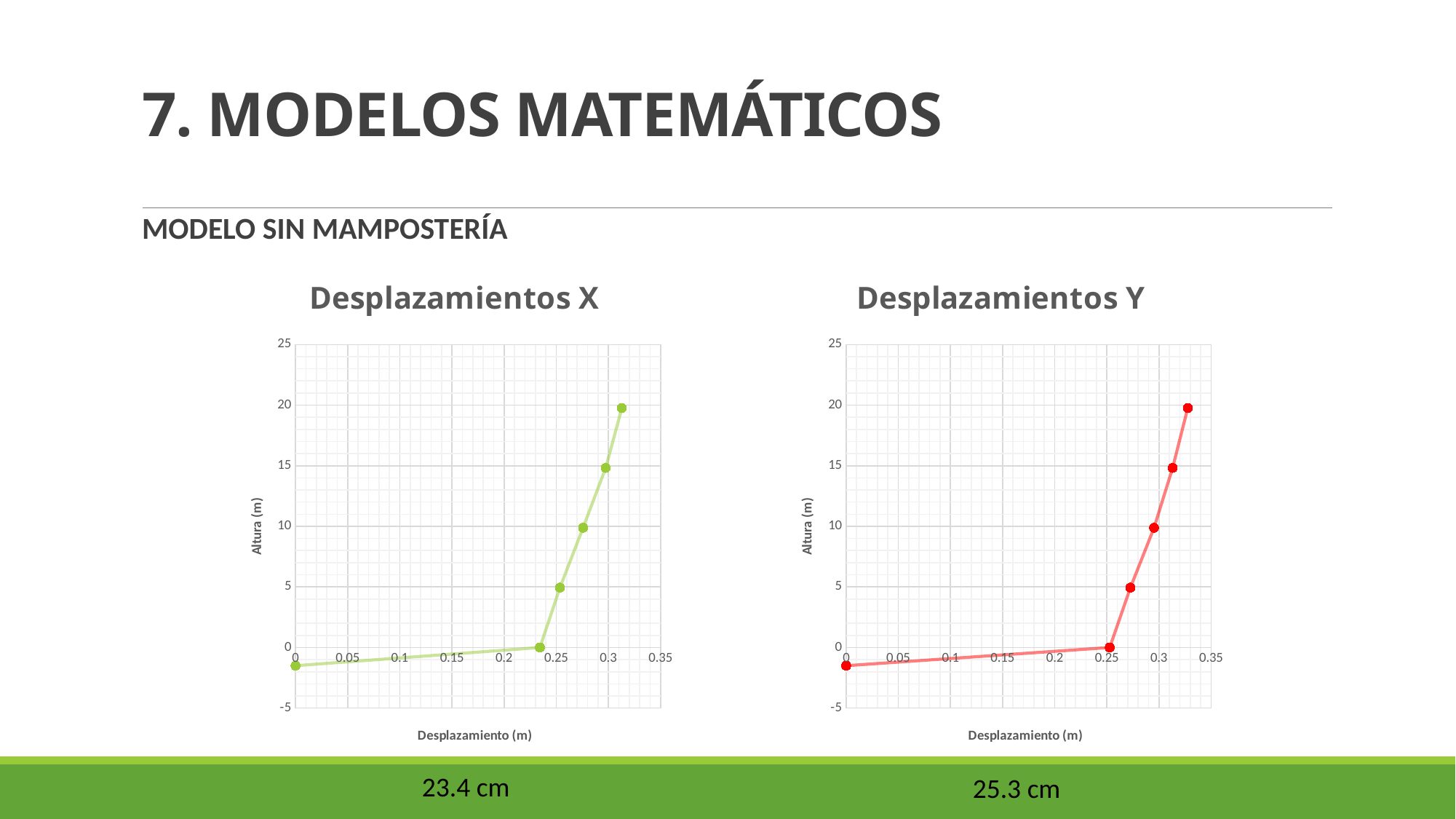
How many data points are plotted in the "Desplazamientos Y" chart? 6 What colour is the line in the "Desplazamientos Y" chart? red In the "Desplazamientos X" chart, does the displacement increase or decrease as the height increases? increase What is the label of the vertical axis in the "Desplazamientos Y" chart? Altura (m) How many data points are plotted in the "Desplazamientos X" chart? 6 In the "Desplazamientos X" chart, is the displacement of the highest point (at about 20 m height) greater or less than 0.3? greater Which chart reaches a larger maximum displacement, "Desplazamientos X" or "Desplazamientos Y"? Desplazamientos Y What kind of chart is the "Desplazamientos X" chart? line chart In the "Desplazamientos Y" chart, is the height of the point at displacement 0 greater or less than 0? less What is the highest value shown on the horizontal axis of the "Desplazamientos X" chart? 0.35 In the "Desplazamientos Y" chart, is the displacement of the highest point greater or less than 0.3? greater